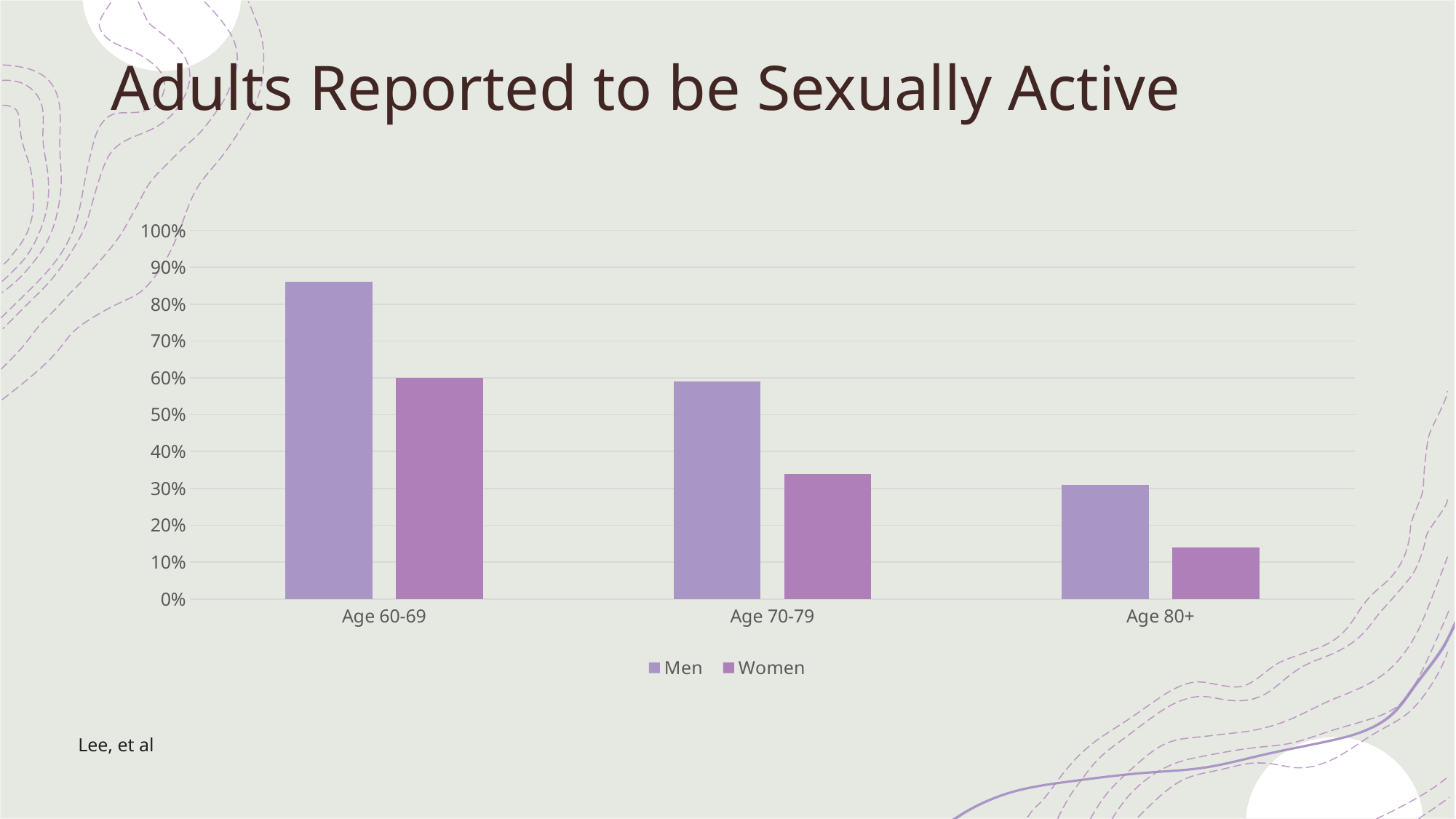
Which bar is the lowest in the chart? Women, Age 80+ How many series does the legend list? 2 For Age 70-79, which is larger, the value for Men or the value for Women? Men Is the value for Women in Age 80+ greater or less than 20%? less What kind of chart is shown on the slide? bar chart Is the value for Men in Age 80+ greater or less than 20%? greater Which bar is the highest in the chart? Men, Age 60-69 Is the value for Women in Age 70-79 greater or less than 40%? less How many age groups are shown on the x axis? 3 Do the values for Men rise or fall as the age groups increase along the x axis? fall What are the two entries in the chart's legend? Men and Women